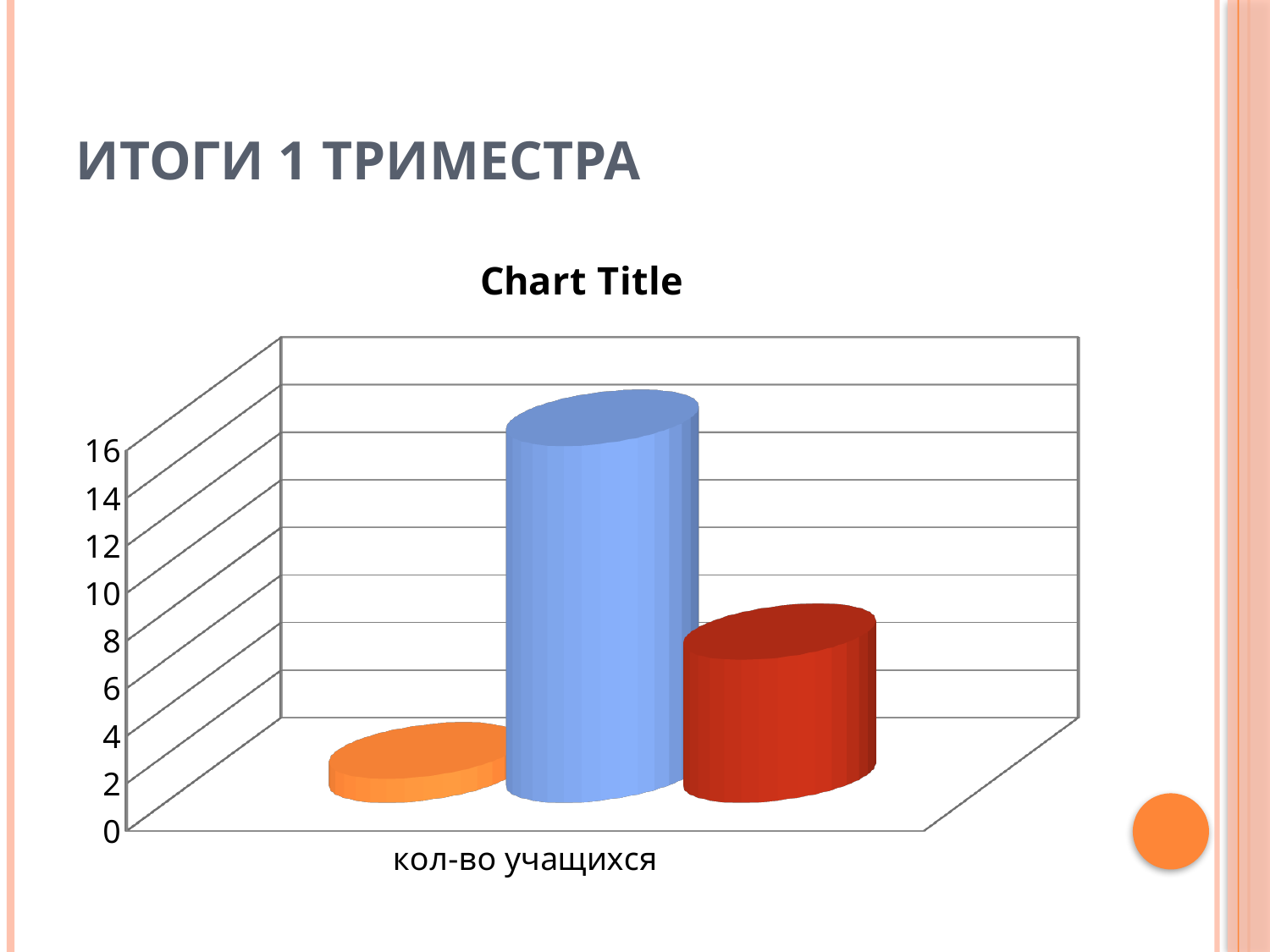
Is the value of the orange bar greater or less than 4? less What is the category label shown on the x axis of the chart? кол-во учащихся Is the value of the red bar greater or less than 4? greater How many bars are plotted in the chart? 3 What is the title shown above the chart? Chart Title What kind of chart is shown on the slide? bar chart Is the value of the red bar greater or less than 12? less Which is larger, the value of the blue bar or the value of the red bar? the blue bar Which is larger, the value of the red bar or the value of the orange bar? the red bar Which bar is the shortest in the chart: the orange, the blue or the red one? the orange one Which bar is the tallest in the chart: the orange, the blue or the red one? the blue one